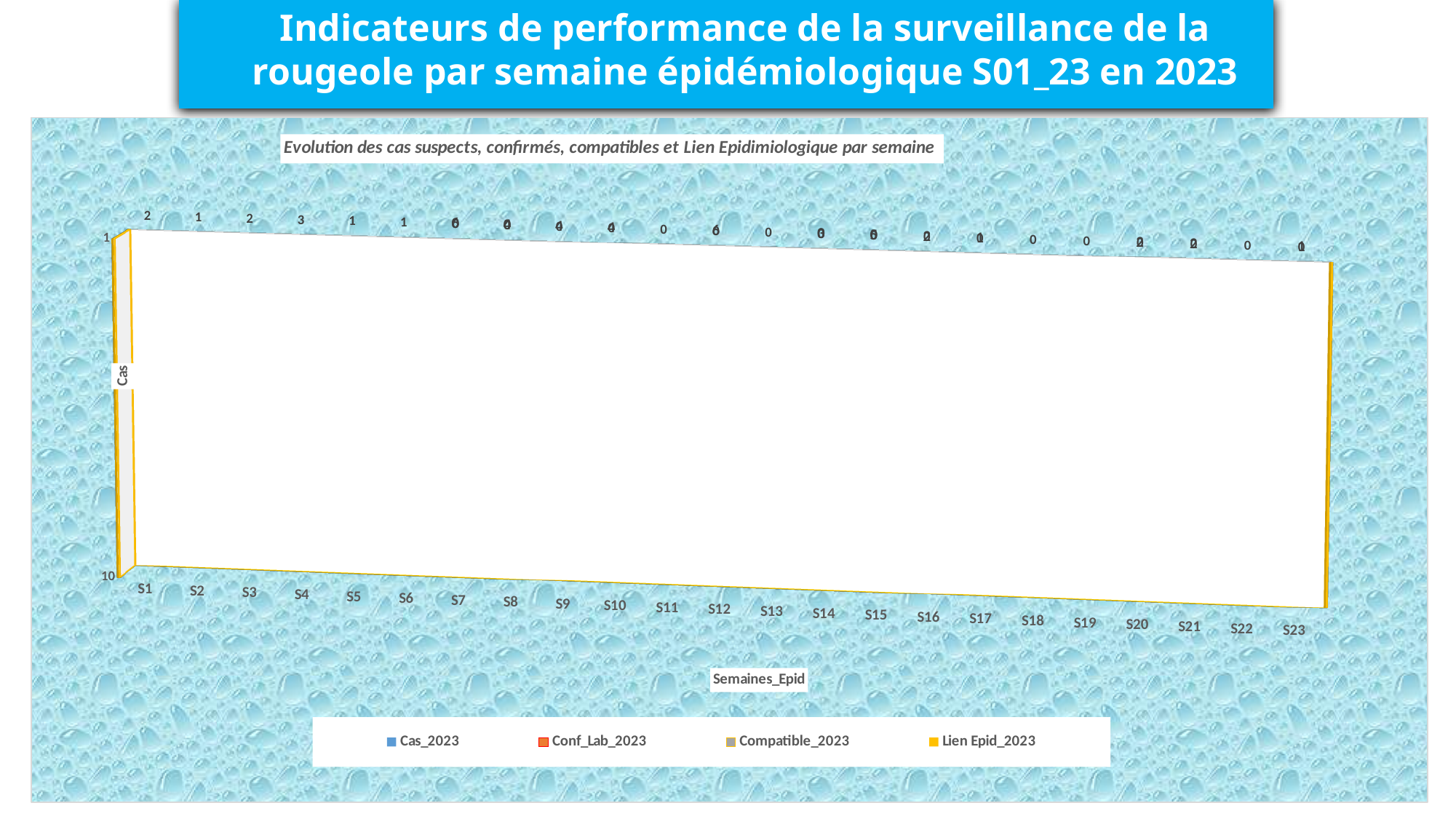
How many week categories are shown on the x axis of the chart? 23 What is the title of the chart? Evolution des cas suspects, confirmés, compatibles et Lien Epidimiologique par semaine What is the label of the x axis of the chart? Semaines_Epid What is the first category on the x axis of the chart? S1 How many series does the chart's legend list? 4 What is the last category on the x axis of the chart? S23